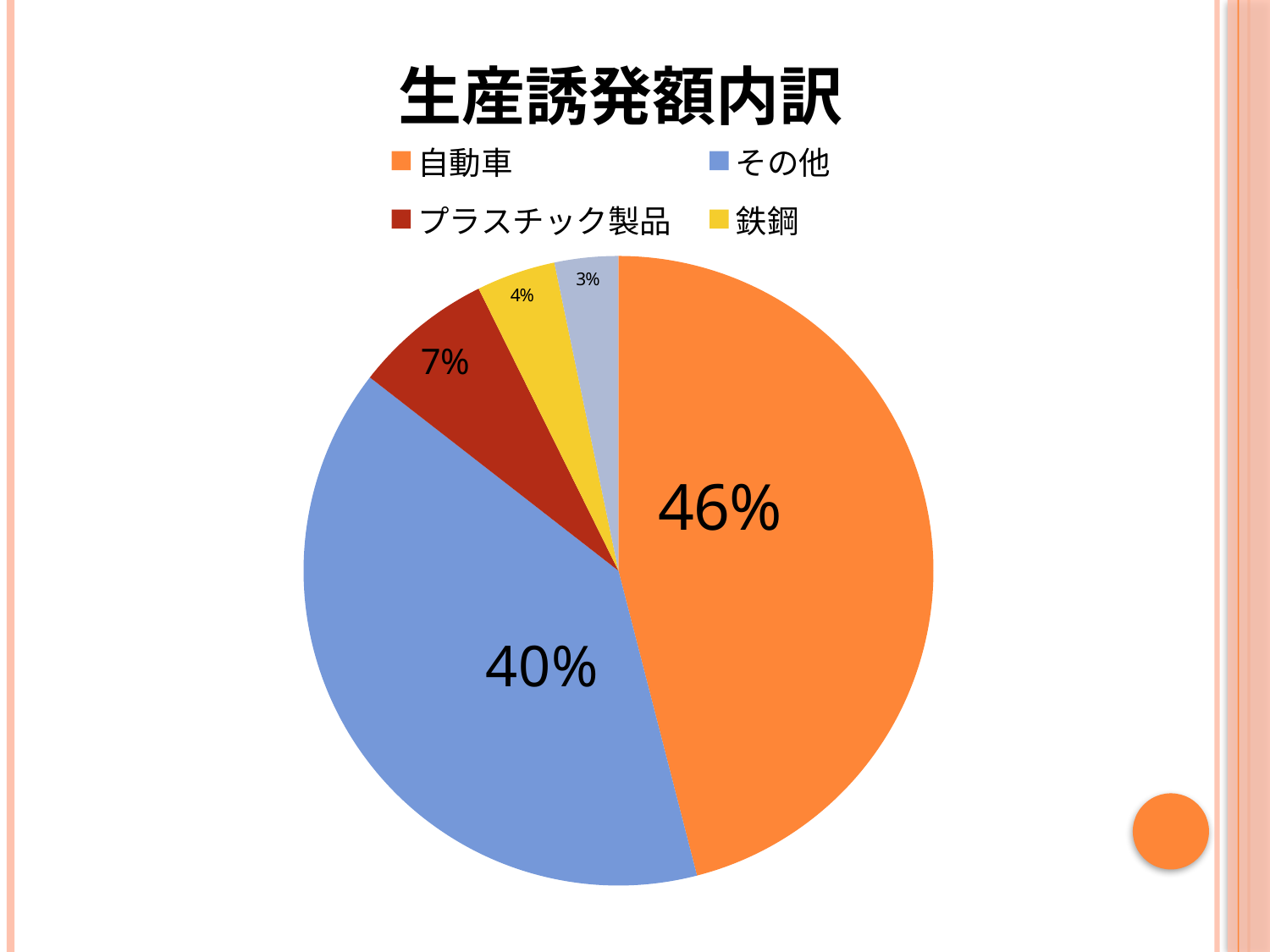
What share of the pie does 自動車 account for? 46% What is the title of the chart? 生産誘発額内訳 How many entries does the legend list? 4 What colour is the slice for その他? blue What share of the pie does 鉄鋼 account for? 4% What kind of chart is shown on the slide? pie chart What share of the pie does プラスチック製品 account for? 7% What is the difference in percentage points between 自動車 and その他? 6 Which is larger, the slice for プラスチック製品 or the slice for 鉄鋼? プラスチック製品 Which of the legend categories has the smallest slice of the pie? 鉄鋼 Which category has the largest slice of the pie? 自動車